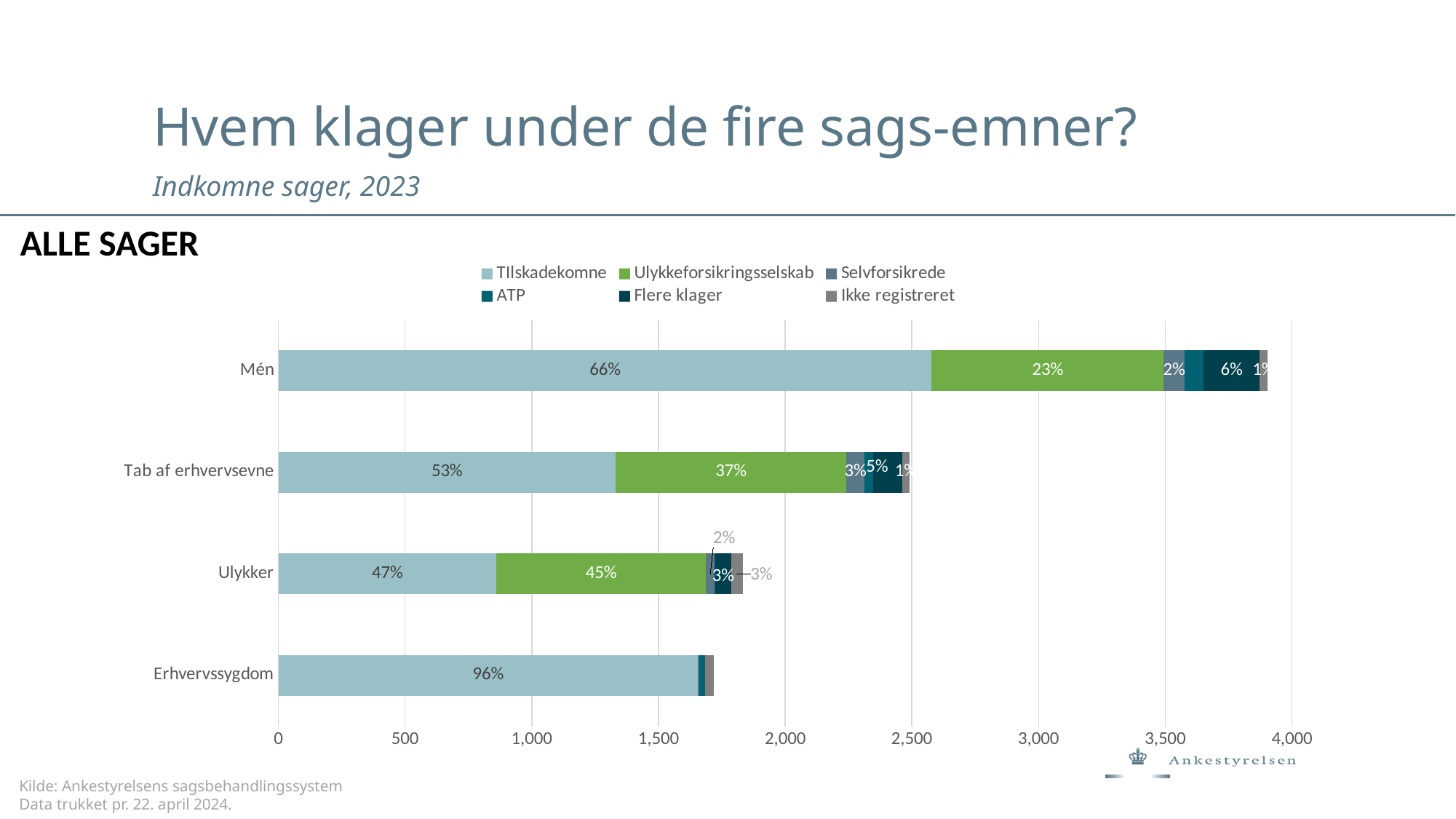
Is the total bar length for Ulykker greater or less than 2,000? less What is the Ulykkeforsikringsselskab share for Ulykker? 45% Which category has the longest total bar? Mén How many categories are shown on the vertical axis? 4 What is the Flere klager share for Mén? 6% What is the Tilskadekomne share for Erhvervssygdom? 96% How many series does the legend list? 6 What is the difference in percentage points between the Tilskadekomne share (66%) and the Ulykkeforsikringsselskab share (23%) for Mén? 43 percentage points Is the total bar length for Mén greater or less than 3,500? greater What is the Tilskadekomne share for Mén? 66% What is the Ulykkeforsikringsselskab share for Tab af erhvervsevne? 37% What kind of chart is shown on the slide? Stacked bar chart